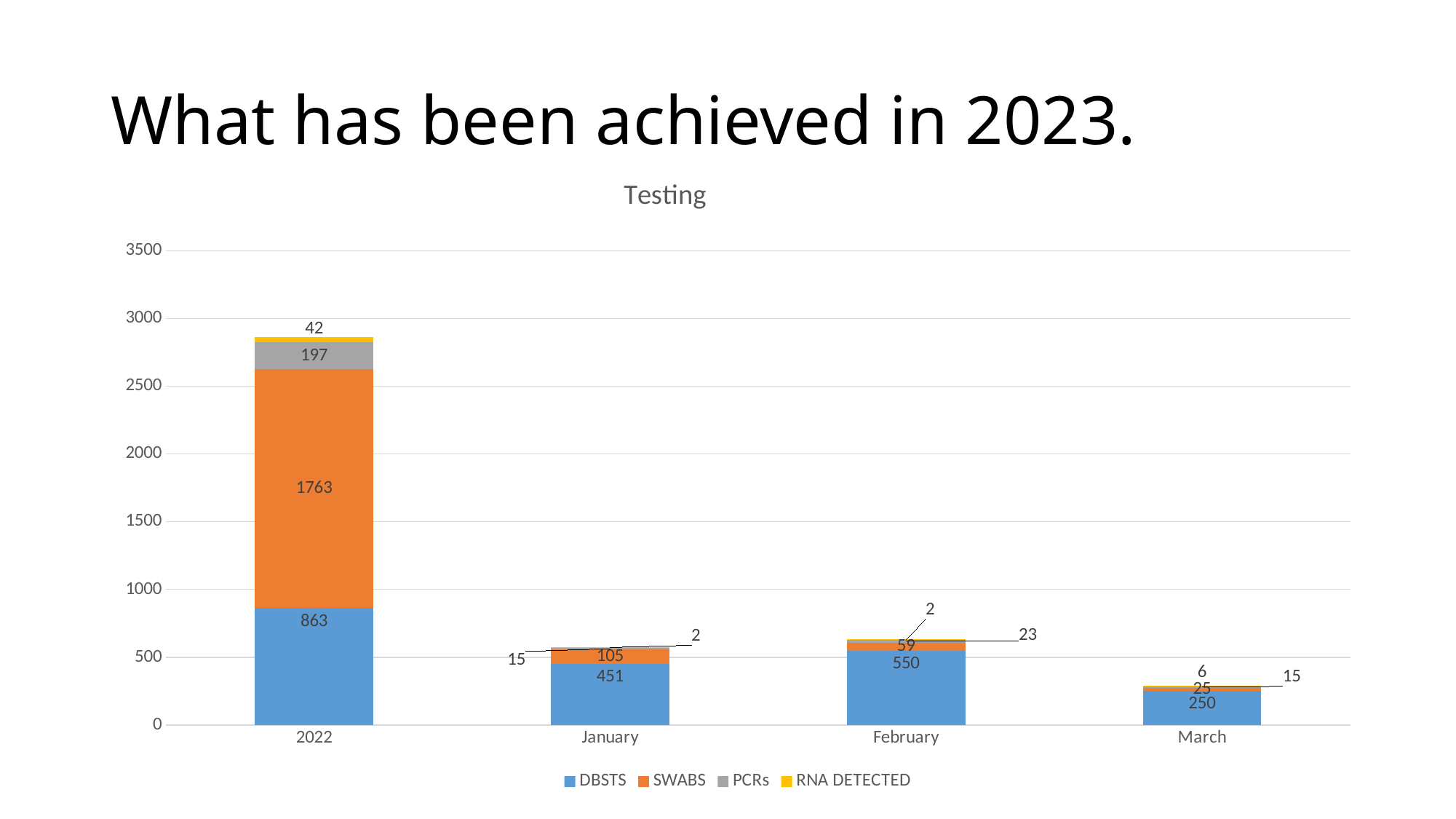
Which category has the highest DBSTS value? 2022 Which category has the lowest SWABS value? March What is the title of the chart? Testing What is the difference between the DBSTS value for 2022 and the DBSTS value for January? 412 What is the SWABS value for 2022? 1763 What is the total of the stacked bar for 2022? 2865 What is the DBSTS value for February? 550 Which is larger, the SWABS value for January or the SWABS value for February? January How many series does the legend list? 4 What kind of chart is shown on the slide? Stacked bar chart How many categories are shown on the x axis? 4 What is the DBSTS value for March? 250